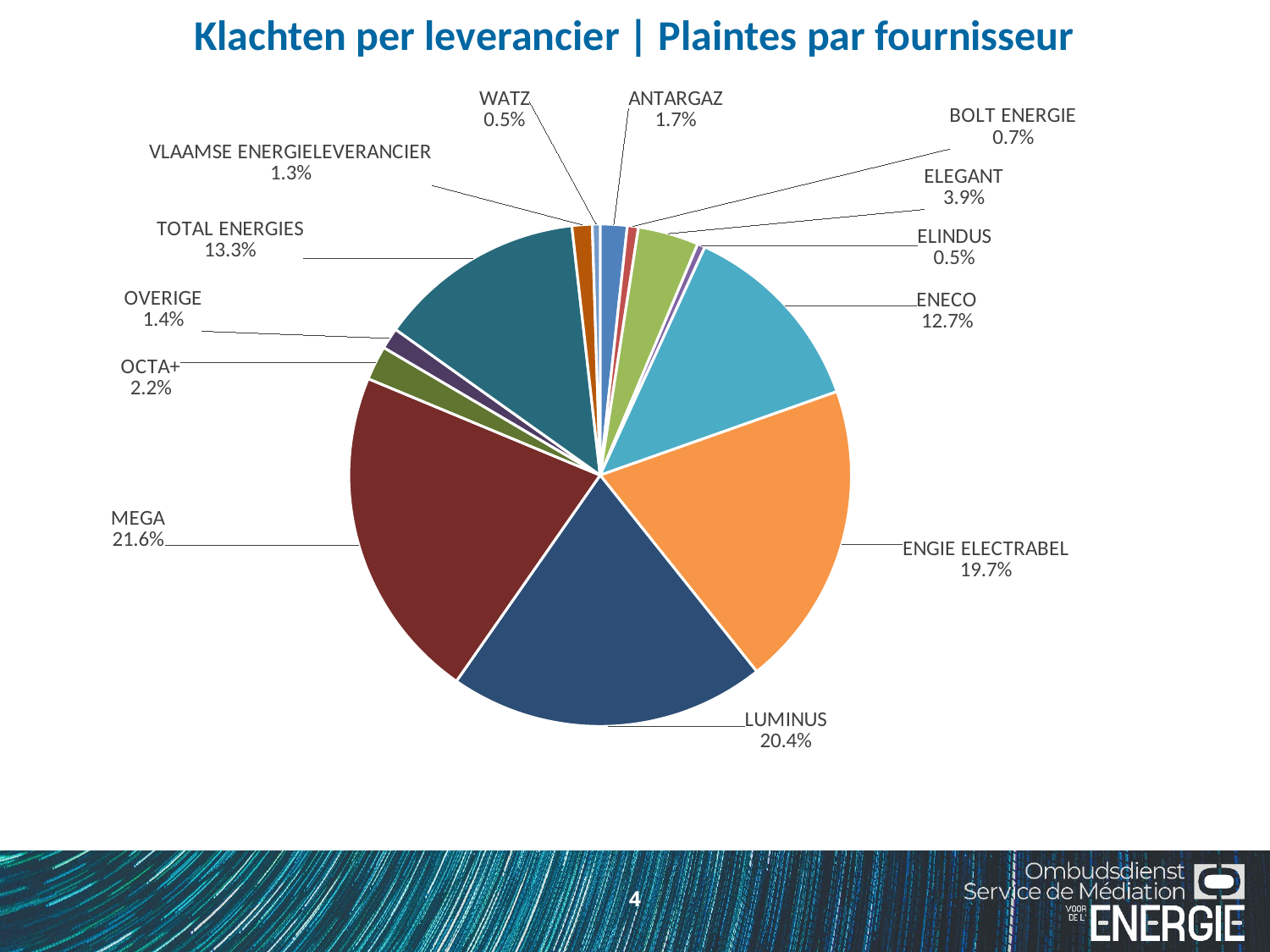
What share of complaints is attributed to MEGA? 21.6% Which has a larger share of complaints, OCTA+ or ANTARGAZ? OCTA+ What share of complaints is attributed to ENECO? 12.7% How many suppliers (slices) are shown in the pie chart? 13 Which has a larger share of complaints, TOTAL ENERGIES or ENECO? TOTAL ENERGIES What is the title of the chart? Klachten per leverancier | Plaintes par fournisseur What kind of chart is shown on the slide? pie chart Which supplier has the largest share of complaints? MEGA What is the difference in percentage points between MEGA and LUMINUS? 1.2 What share of complaints is attributed to TOTAL ENERGIES? 13.3% What share of complaints is attributed to ELEGANT? 3.9% What is the difference in percentage points between ENGIE ELECTRABEL and ENECO? 7.0